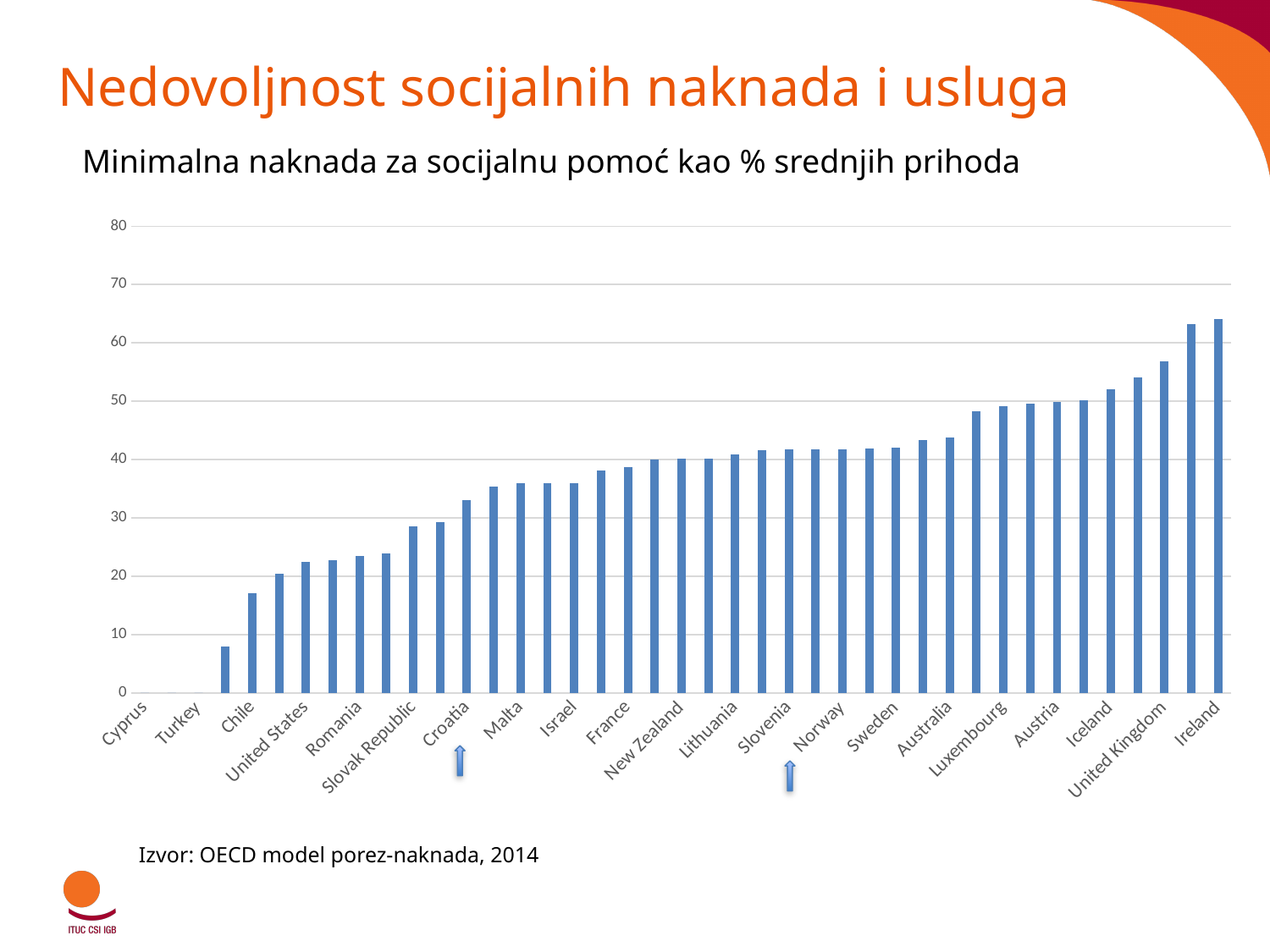
Is the value for Croatia greater or less than 20? greater What is the title of the chart? Minimalna naknada za socijalnu pomoć kao % srednjih prihoda Which has a larger value, Ireland or Chile? Ireland Is the value for United Kingdom greater or less than 50? greater Is the value for Ireland greater or less than 60? greater What kind of chart is shown on the slide? bar chart Which country has the highest value in the chart? Ireland Do the values generally rise or fall from left to right along the x axis? rise How many country labels are shown on the x axis? 21 Which has a larger value, Sweden or Croatia? Sweden